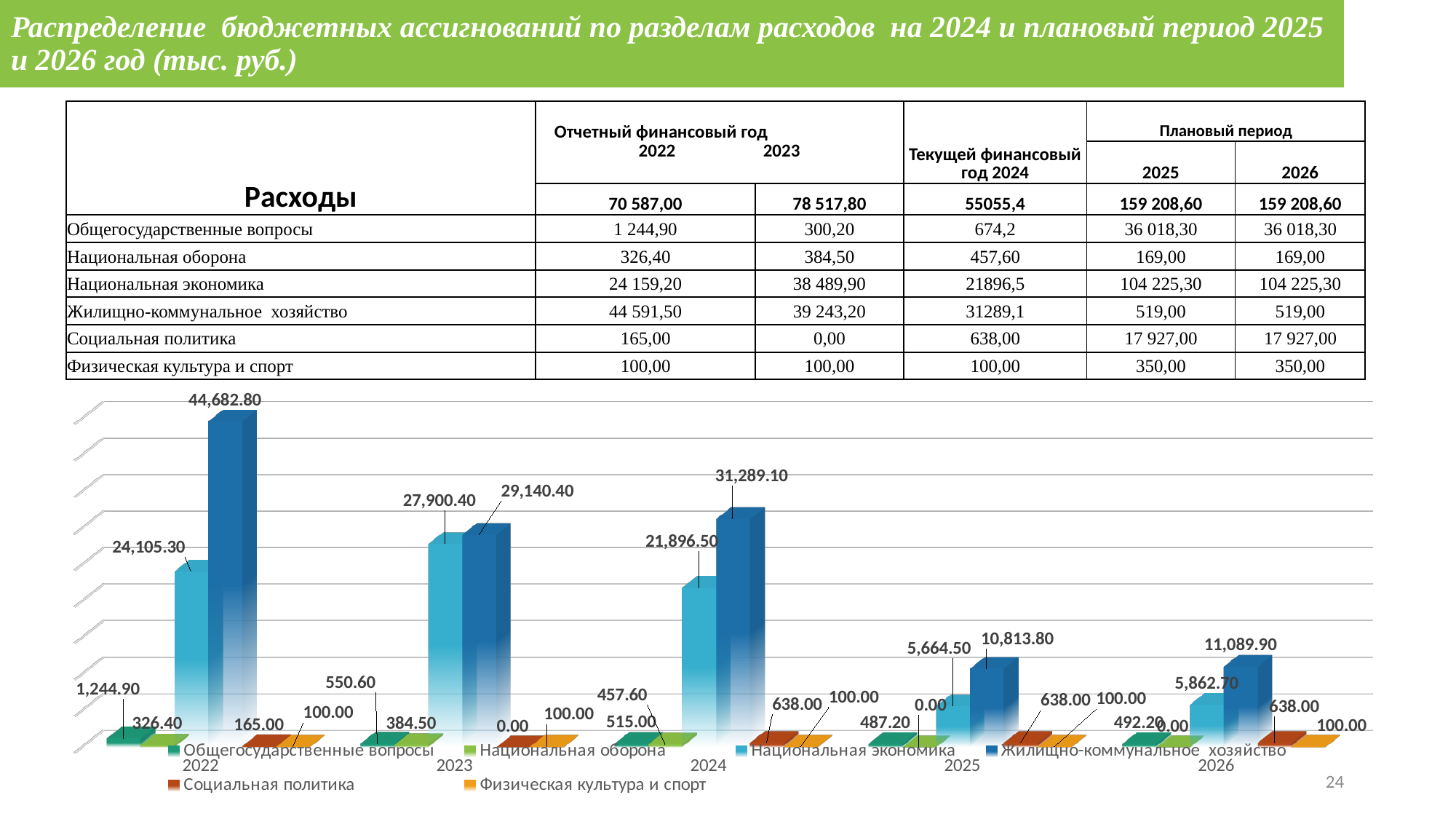
In the chart for 2023, which is larger: Национальная экономика or Жилищно-коммунальное хозяйство? Жилищно-коммунальное хозяйство In the chart, what is the value for Физическая культура и спорт in 2025? 100.00 In the chart, what is the value for Национальная экономика in 2024? 21,896.50 In which year does Жилищно-коммунальное хозяйство have its highest value in the chart? 2022 In the chart, what is the difference between the Жилищно-коммунальное хозяйство values for 2026 and 2025? 276.10 In the chart, what is the value for Жилищно-коммунальное хозяйство in 2022? 44,682.80 In the chart, does the value for Национальная экономика rise or fall from 2024 to 2025? fall What kind of chart is shown below the table? bar chart In which year does Жилищно-коммунальное хозяйство have its lowest value in the chart? 2025 In the chart, what is the difference between Жилищно-коммунальное хозяйство and Национальная экономика in 2022? 20,577.50 How many series does the chart legend list? 6 How many years are shown along the x axis of the chart? 5